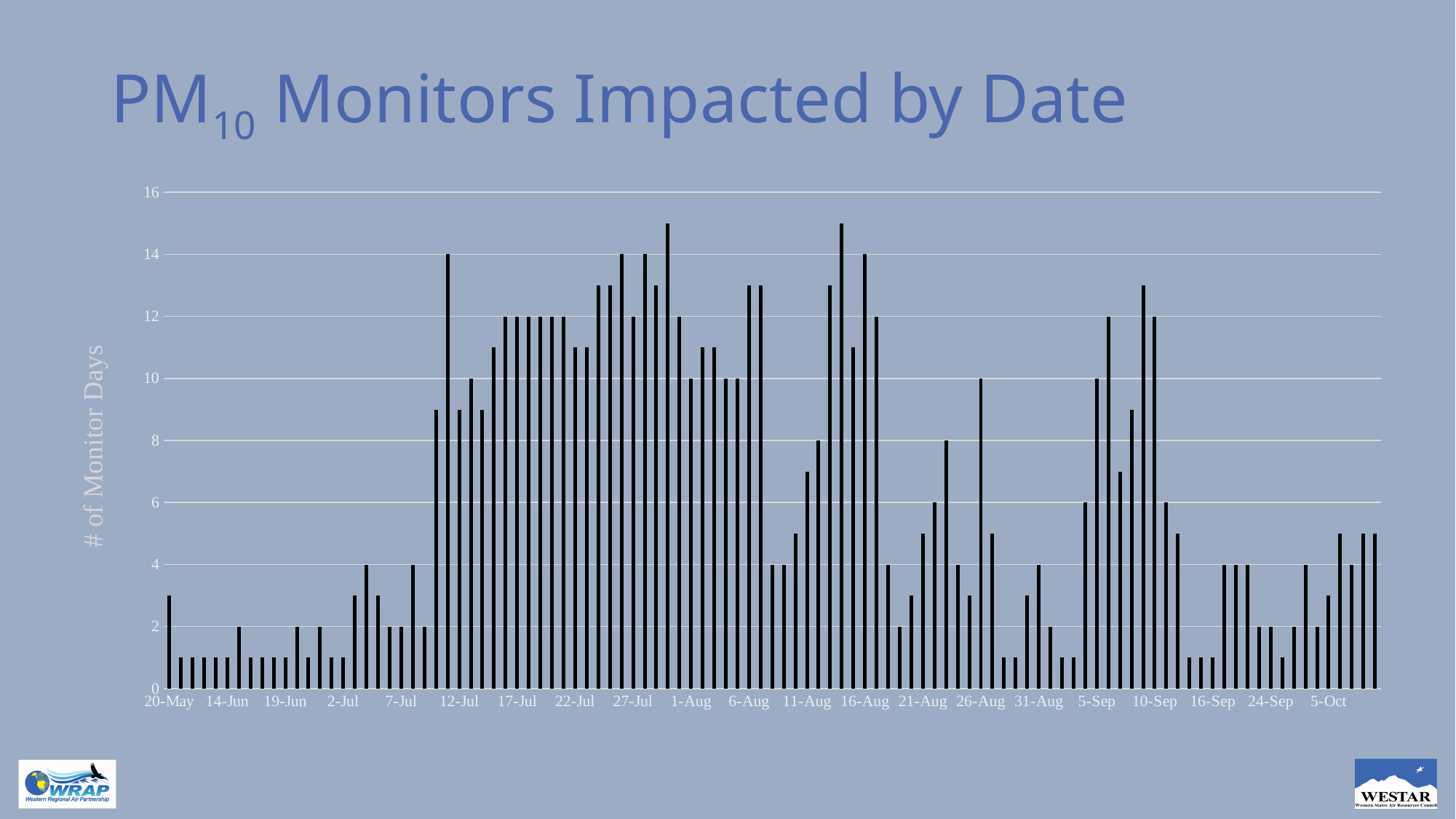
Which has the larger value, 20-May or 14-Jun? 20-May What is the highest value shown on the vertical axis? 16 Is the value for 20-May greater or less than 2? greater What kind of chart is shown on the slide? bar chart Is the value for 14-Jun greater or less than 2? less Which has the larger value, 26-Aug or 31-Aug? 26-Aug Is the value for 5-Sep greater or less than 8? greater What is the label on the vertical axis of the chart? # of Monitor Days What is the title of the chart? PM10 Monitors Impacted by Date